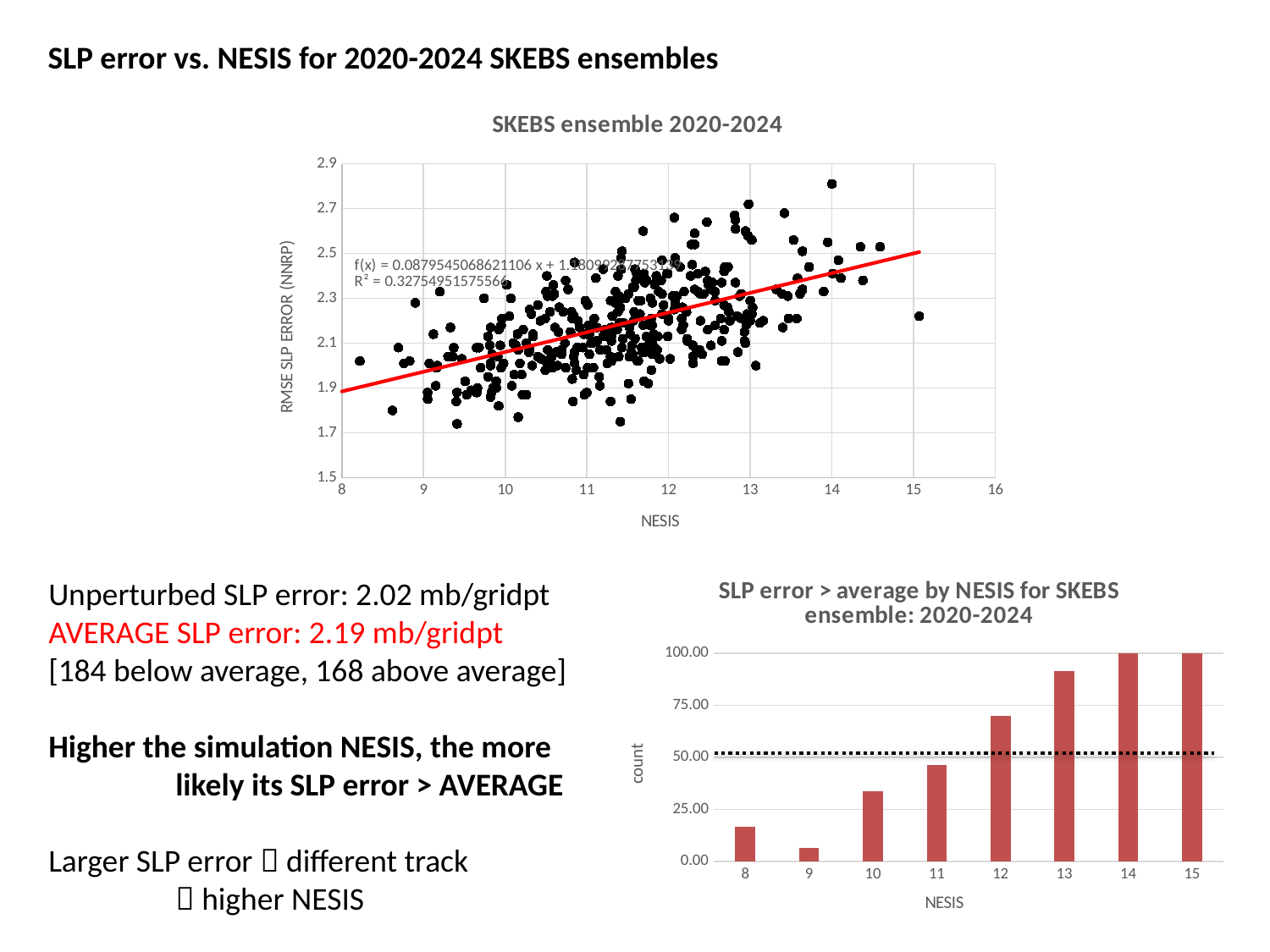
What kind of chart is the bottom-right chart titled 'SLP error > average by NESIS for SKEBS ensemble: 2020-2024'? bar chart What is the y-axis label of the top scatter chart? RMSE SLP ERROR (NNRP) In the bottom-right bar chart, which NESIS category has the lowest count? 9 What kind of chart is the top chart titled 'SKEBS ensemble 2020-2024'? scatter plot In the bottom-right bar chart, what is the count for NESIS 15? 100.00 In the top scatter chart, does RMSE SLP error tend to rise or fall as NESIS increases? rise In the top scatter chart, what R² value is printed for the trend line? 0.32754951575566 In the bottom-right bar chart, is the count for NESIS 10 greater or less than 50.00? less In the bottom-right bar chart, what is the count for NESIS 14? 100.00 In the bottom-right bar chart, which has the larger count, NESIS 11 or NESIS 13? NESIS 13 In the bottom-right bar chart, is the count for NESIS 12 greater or less than 50.00? greater How many bars are shown in the bottom-right bar chart? 8